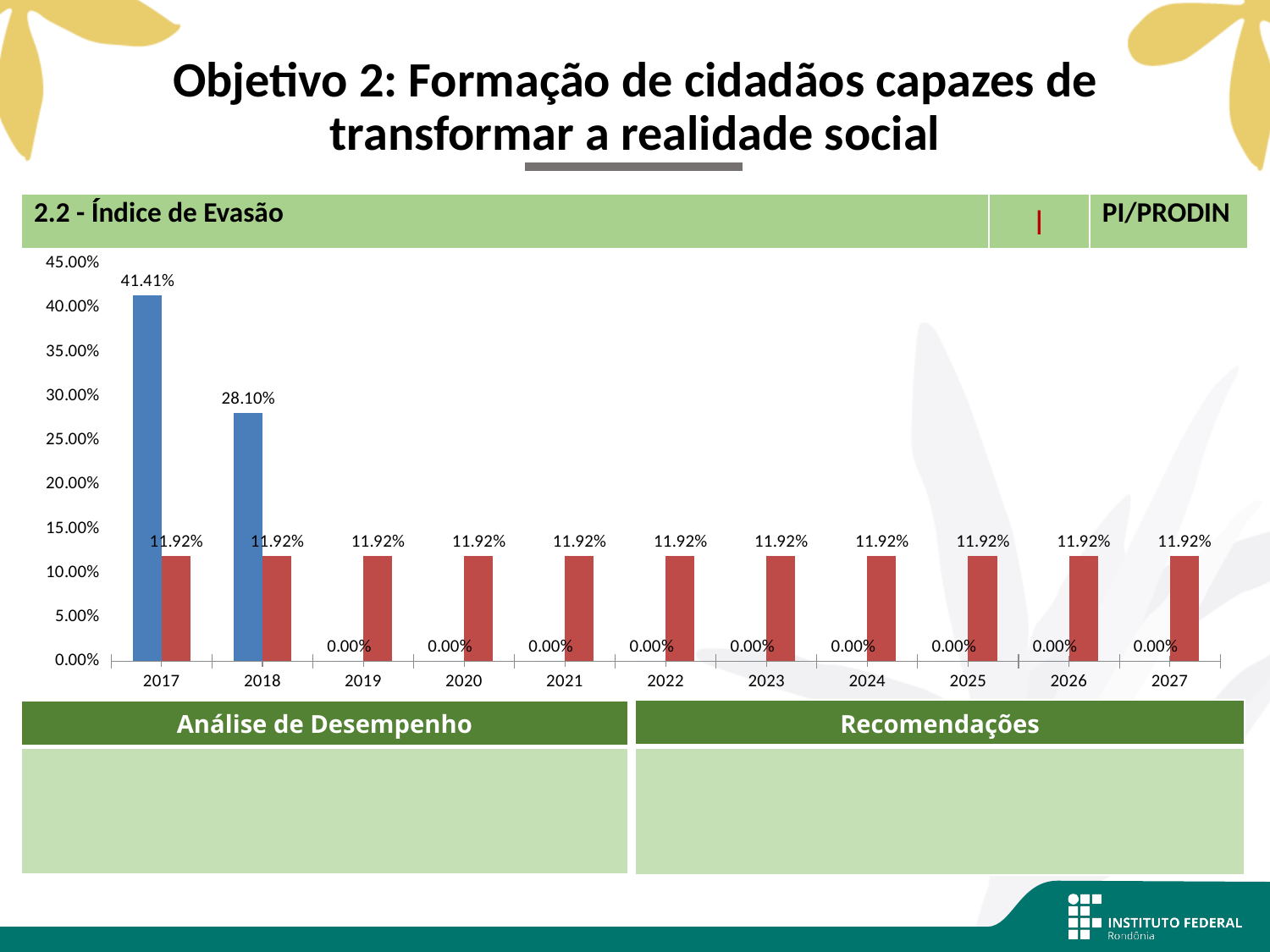
What type of chart is shown on the slide? bar chart What is the value of the red bar for 2022? 11.92% What is the value of the blue bar for 2017? 41.41% What is the difference between the blue bar values for 2017 and 2018? 13.31% What is the title of the chart? 2.2 - Índice de Evasão What is the value of the blue bar for 2025? 0.00% What is the difference between the blue bar and the red bar for 2018? 16.18% Which year has the highest blue bar? 2017 Do the blue bar values rise or fall from 2017 to 2019? fall Which is larger for 2017, the blue bar or the red bar? the blue bar What is the value of the blue bar for 2018? 28.10% How many years are shown on the x axis? 11